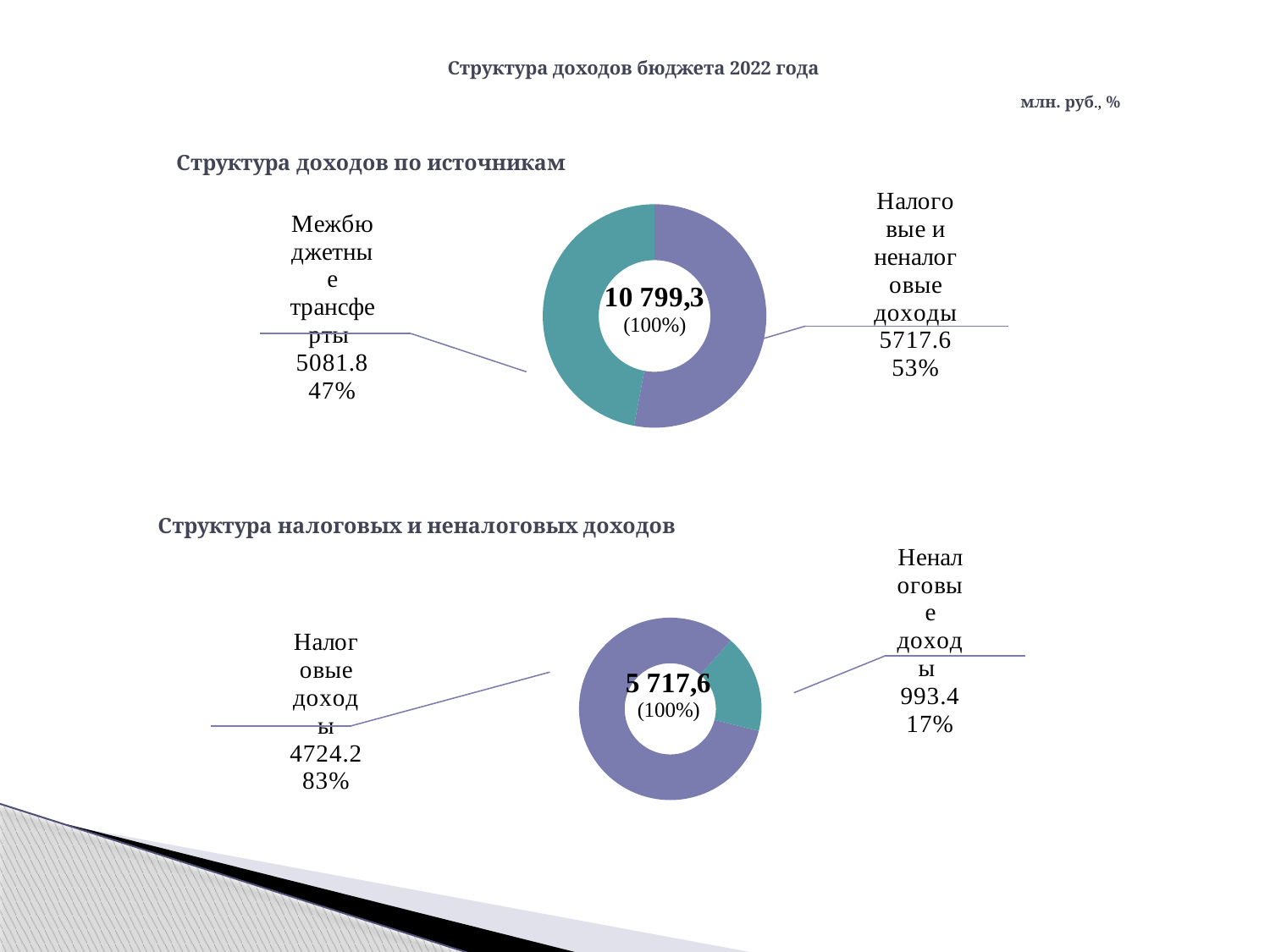
In the chart 'Структура доходов по источникам', which category has the larger value? Налоговые и неналоговые доходы In the chart 'Структура налоговых и неналоговых доходов', what is the difference between Налоговые доходы and Неналоговые доходы? 3730.8 In the chart 'Структура доходов по источникам', what total is shown in the centre of the doughnut? 10 799,3 In the chart 'Структура налоговых и неналоговых доходов', what colour is the Неналоговые доходы slice? Teal In the chart 'Структура доходов по источникам', what share of the total do Налоговые и неналоговые доходы make up? 53% What type of chart is used for 'Структура налоговых и неналоговых доходов'? Doughnut chart In the chart 'Структура доходов по источникам', how many categories are shown? 2 In the chart 'Структура налоговых и неналоговых доходов', what is the value for Неналоговые доходы? 993.4 In the chart 'Структура доходов по источникам', what is the value for Межбюджетные трансферты? 5081.8 In the chart 'Структура доходов по источникам', what is the difference between Налоговые и неналоговые доходы and Межбюджетные трансферты? 635.8 In the chart 'Структура налоговых и неналоговых доходов', what share of the total do Налоговые доходы make up? 83% In the chart 'Структура налоговых и неналоговых доходов', which category has the smallest value? Неналоговые доходы